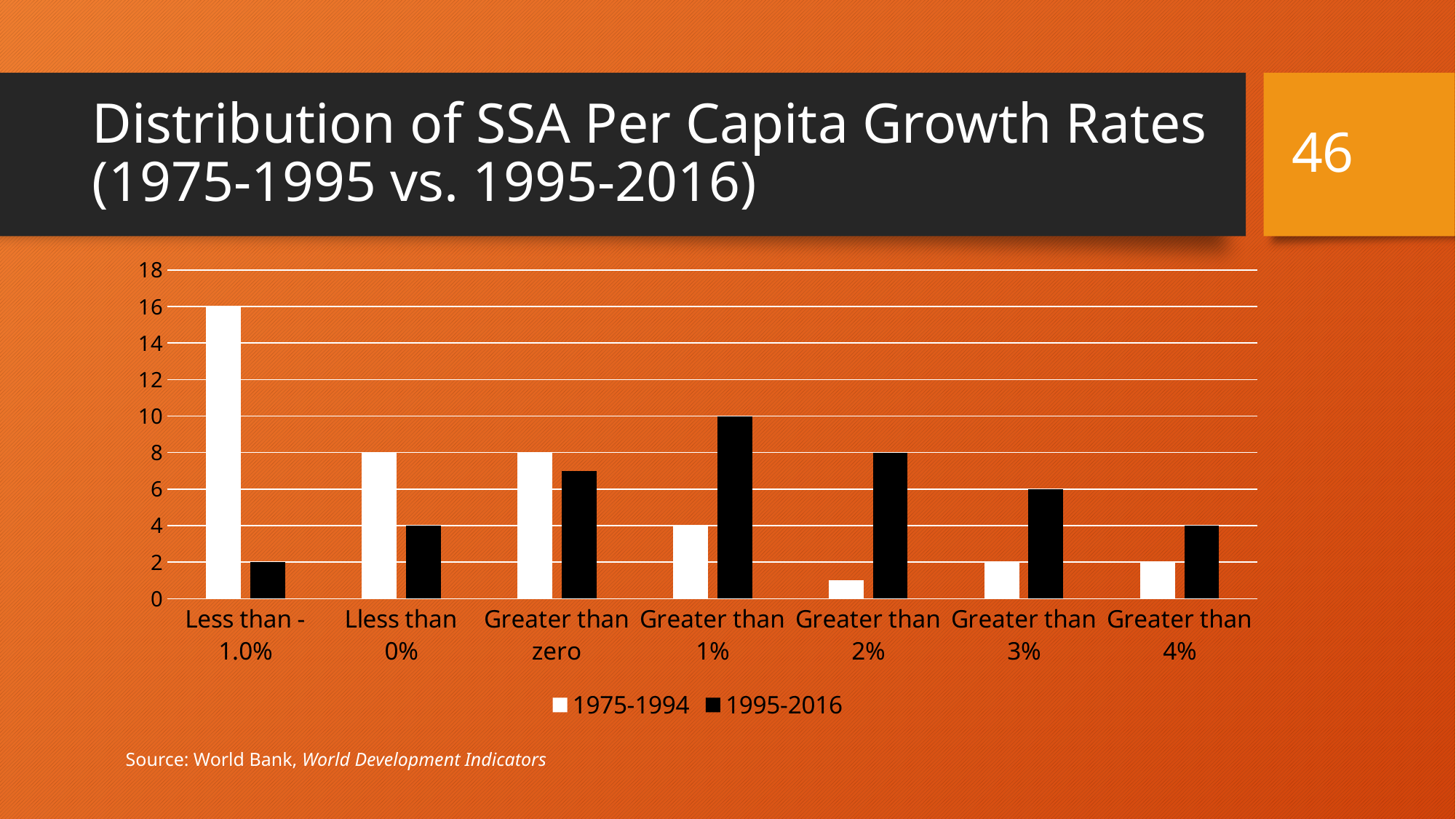
What is the value for 1975-1994 in the 'Less than -1.0%' category? 16 Which category has the highest value for the 1975-1994 series? Less than -1.0% What colour are the bars for the 1995-2016 series? black Which category has the highest value for the 1995-2016 series? Greater than 1% How many categories are shown on the x axis? 7 Is the value for 1995-2016 in the 'Greater than zero' category greater or less than 6? greater In the 'Greater than 3%' category, which series has the larger value, 1975-1994 or 1995-2016? 1995-2016 What is the value for 1995-2016 in the 'Greater than 3%' category? 6 What is the value for 1995-2016 in the 'Greater than 1%' category? 10 How many series does the legend list? 2 In the 'Less than -1.0%' category, what is the difference between the 1975-1994 value and the 1995-2016 value? 14 What kind of chart is shown on the slide? bar chart